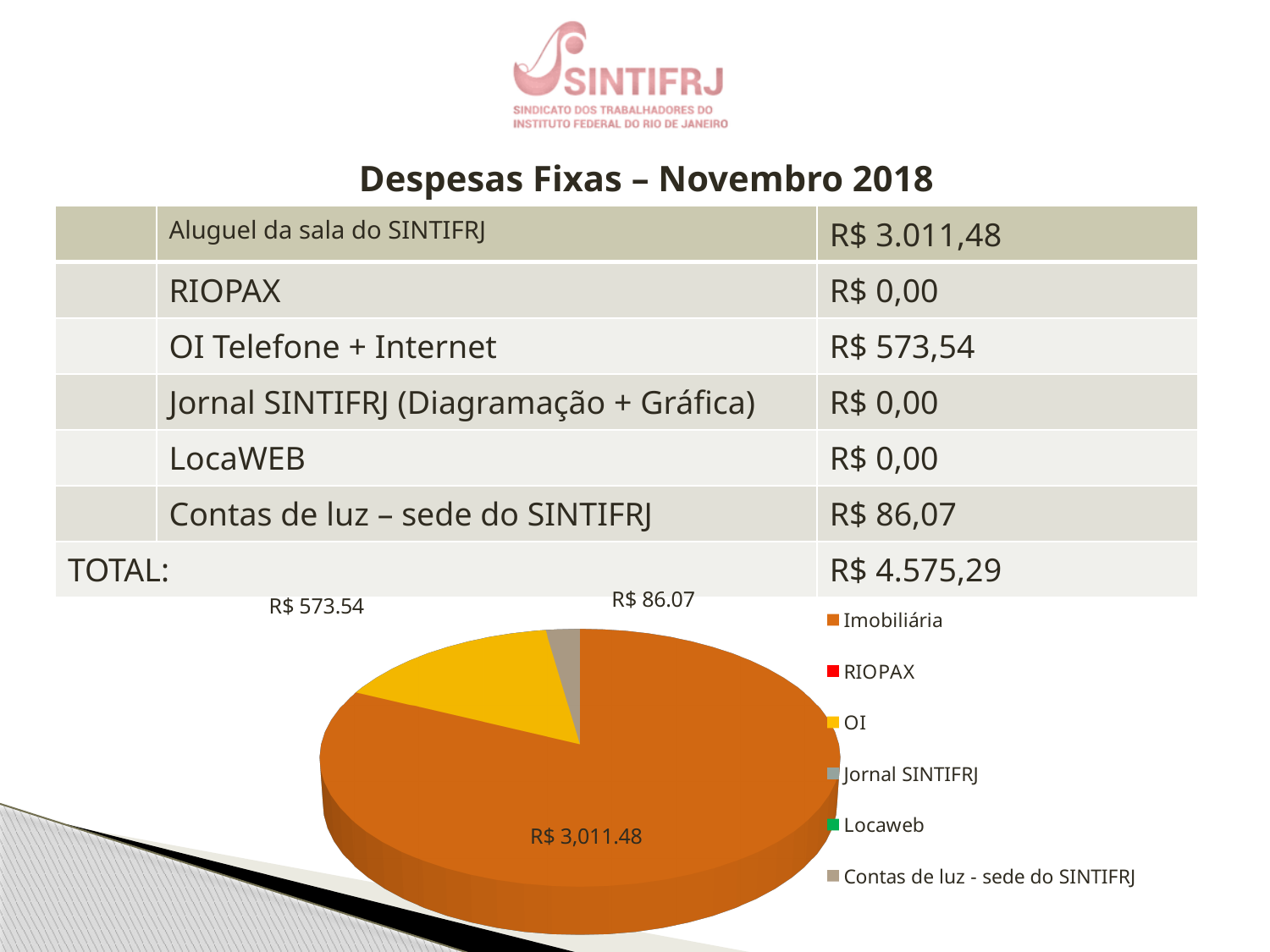
What value is labelled on the yellow (OI) slice of the pie chart? R$ 573.54 Which category has the largest slice in the pie chart? Imobiliária How many entries does the pie chart's legend list? 6 What colour is the Imobiliária slice in the pie chart? orange What is the last entry listed in the pie chart's legend? Contas de luz - sede do SINTIFRJ What value is labelled on the grey (Contas de luz - sede do SINTIFRJ) slice of the pie chart? R$ 86.07 What is the difference between the R$ 573.54 slice and the R$ 86.07 slice in the pie chart? R$ 487.47 What value is labelled on the largest slice of the pie chart? R$ 3,011.48 Which is larger in the pie chart, the OI slice or the Contas de luz - sede do SINTIFRJ slice? OI What is the difference between the R$ 3,011.48 slice and the R$ 573.54 slice in the pie chart? R$ 2,437.94 What kind of chart is shown on the slide? pie chart